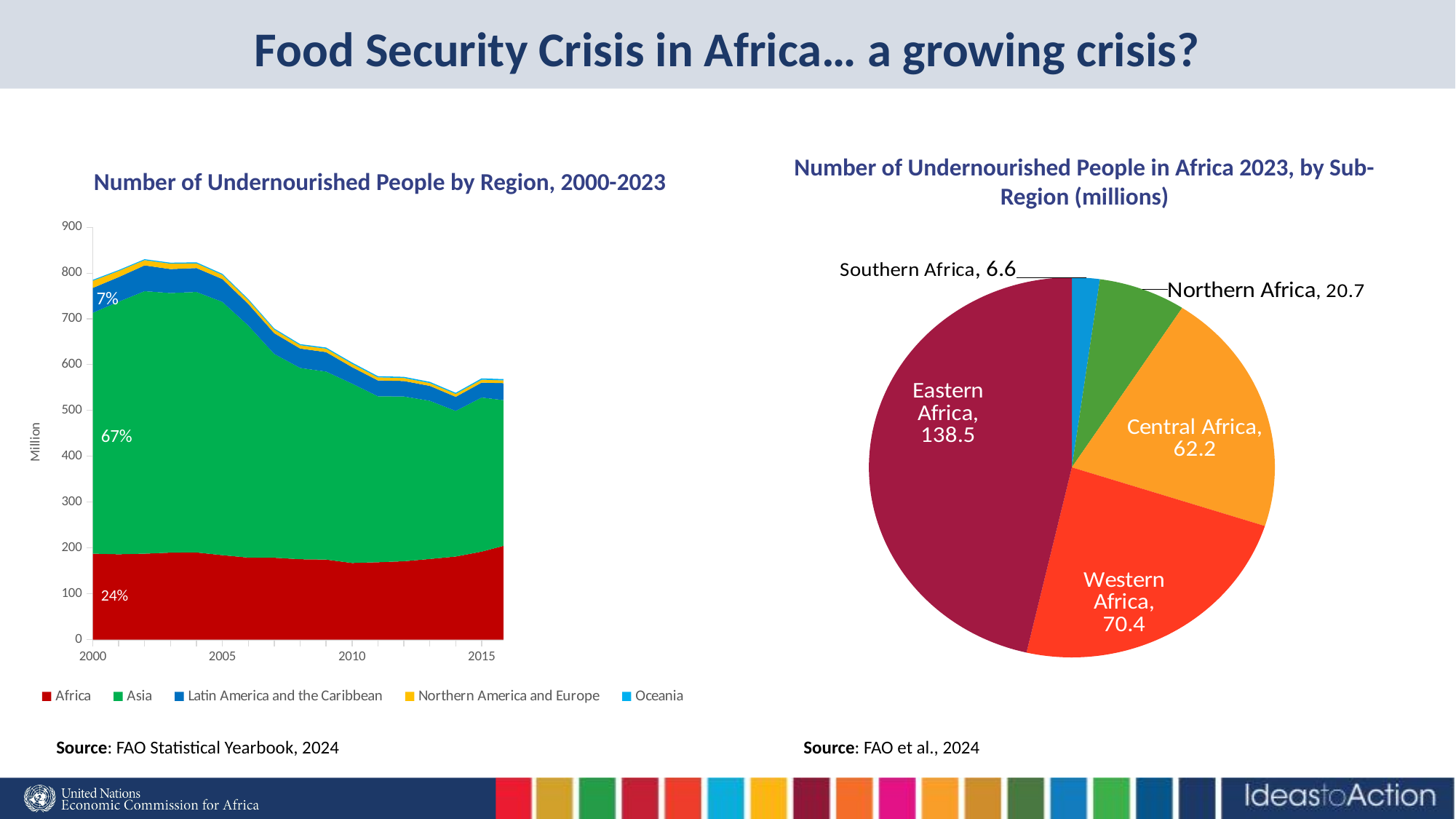
In the chart on the left, does the total number of undernourished people rise or fall between 2005 and 2015? fall In the pie chart on the right, which sub-region has the smallest number of undernourished people? Southern Africa In the pie chart on the right, what is the difference between the values for Eastern Africa and Western Africa? 68.1 In the chart on the left, how many series does the legend list? 5 In the chart on the left, what percentage label is shown on the Asia area? 67% In the pie chart on the right, what is the total of all sub-region values shown? 298.4 In the pie chart on the right, how many undernourished people (millions) are in Eastern Africa? 138.5 In the pie chart on the right, which sub-region has the largest number of undernourished people? Eastern Africa What kind of chart is the 'Number of Undernourished People by Region, 2000-2023' chart on the left? stacked area chart In the pie chart on the right, how many sub-regions are shown? 5 In the pie chart on the right, which is larger: Western Africa or Central Africa? Western Africa In the pie chart on the right, what is the value for Southern Africa? 6.6